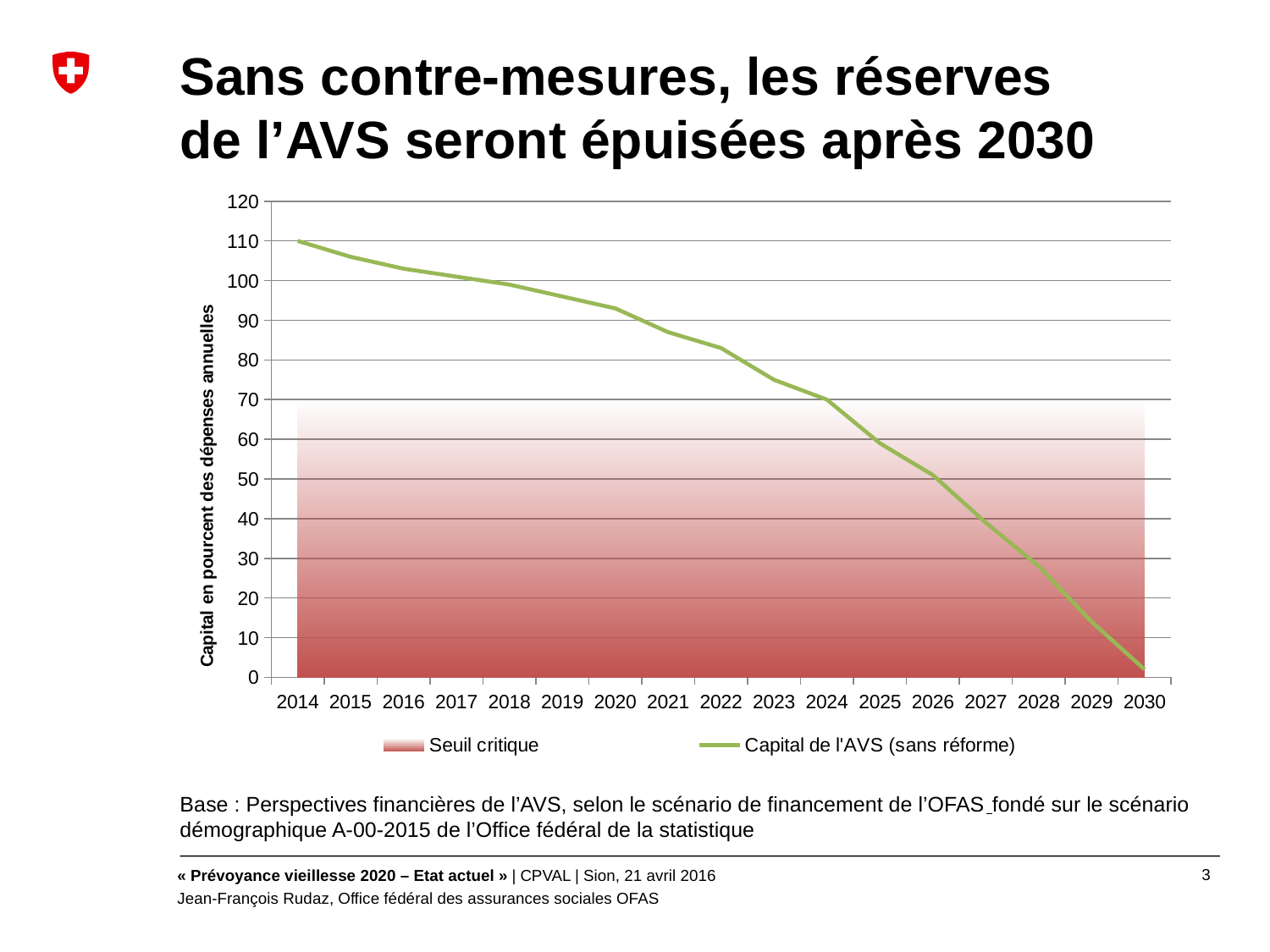
In which year is the 'Capital de l'AVS (sans réforme)' value lowest? 2030 How many series does the legend list? 2 What is the label of the y axis? Capital en pourcent des dépenses annuelles Is the 'Capital de l'AVS (sans réforme)' value for 2028 greater or less than 40? less What is the name of the shaded red area in the legend? Seuil critique Which year has a larger 'Capital de l'AVS (sans réforme)' value, 2018 or 2025? 2018 Is the 'Capital de l'AVS (sans réforme)' value for 2026 greater or less than 60? less In which year is the 'Capital de l'AVS (sans réforme)' value highest? 2014 How many years are shown along the x axis? 17 Is the 'Capital de l'AVS (sans réforme)' value for 2020 greater or less than 90? greater Does the 'Capital de l'AVS (sans réforme)' line rise or fall from 2014 to 2030? fall What kind of chart is shown on the slide? line chart